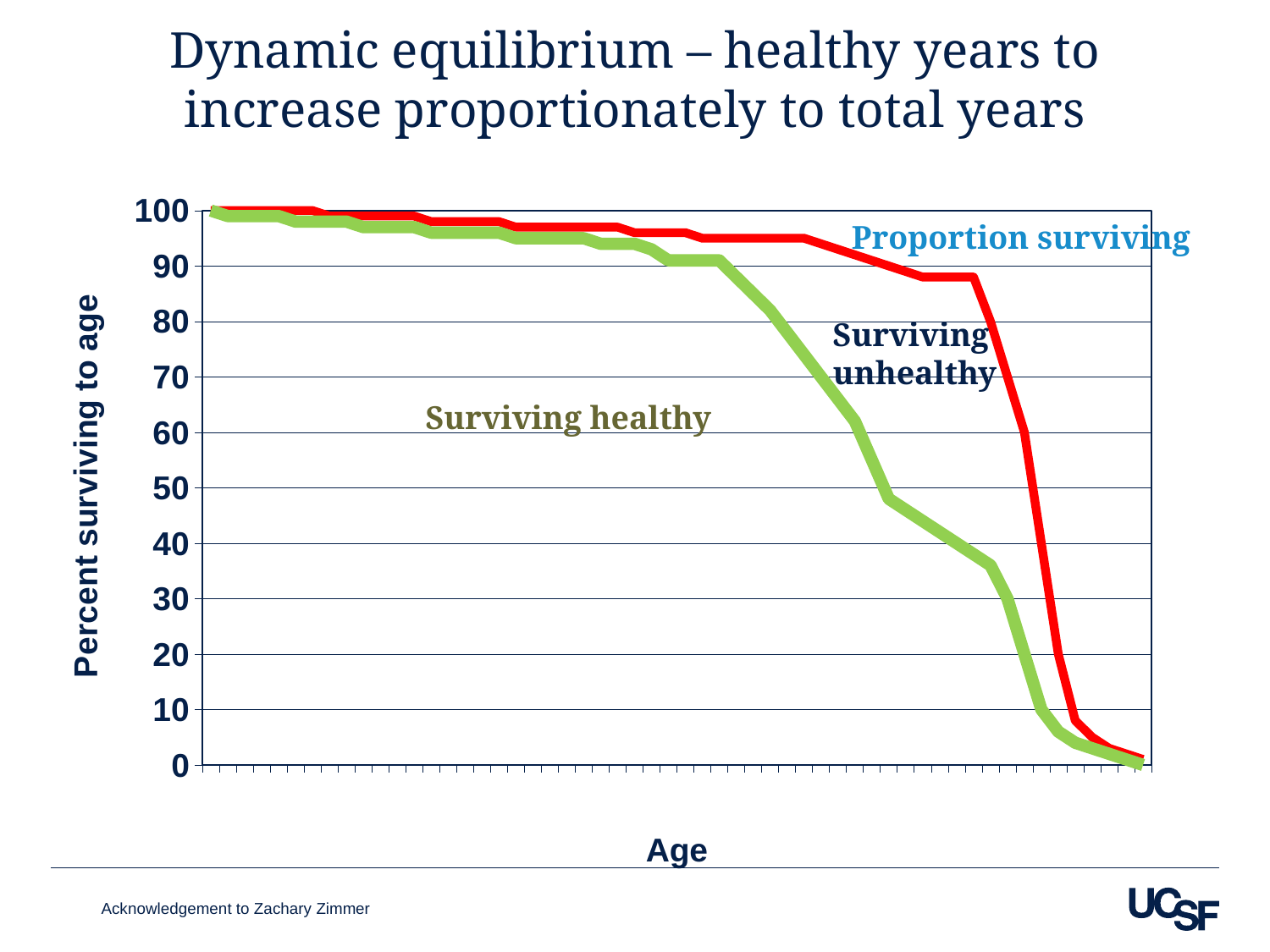
What colour is the Surviving healthy line? Green Which line is higher across the chart, Proportion surviving or Surviving healthy? Proportion surviving Do the plotted values rise or fall as age increases along the x axis? Fall What is the title of the y axis? Percent surviving to age At what value does the Proportion surviving line start at the left of the chart? 100 What is the highest value shown on the y axis? 100 How many lines are plotted on the chart? 2 What kind of chart is shown on the slide? Line chart